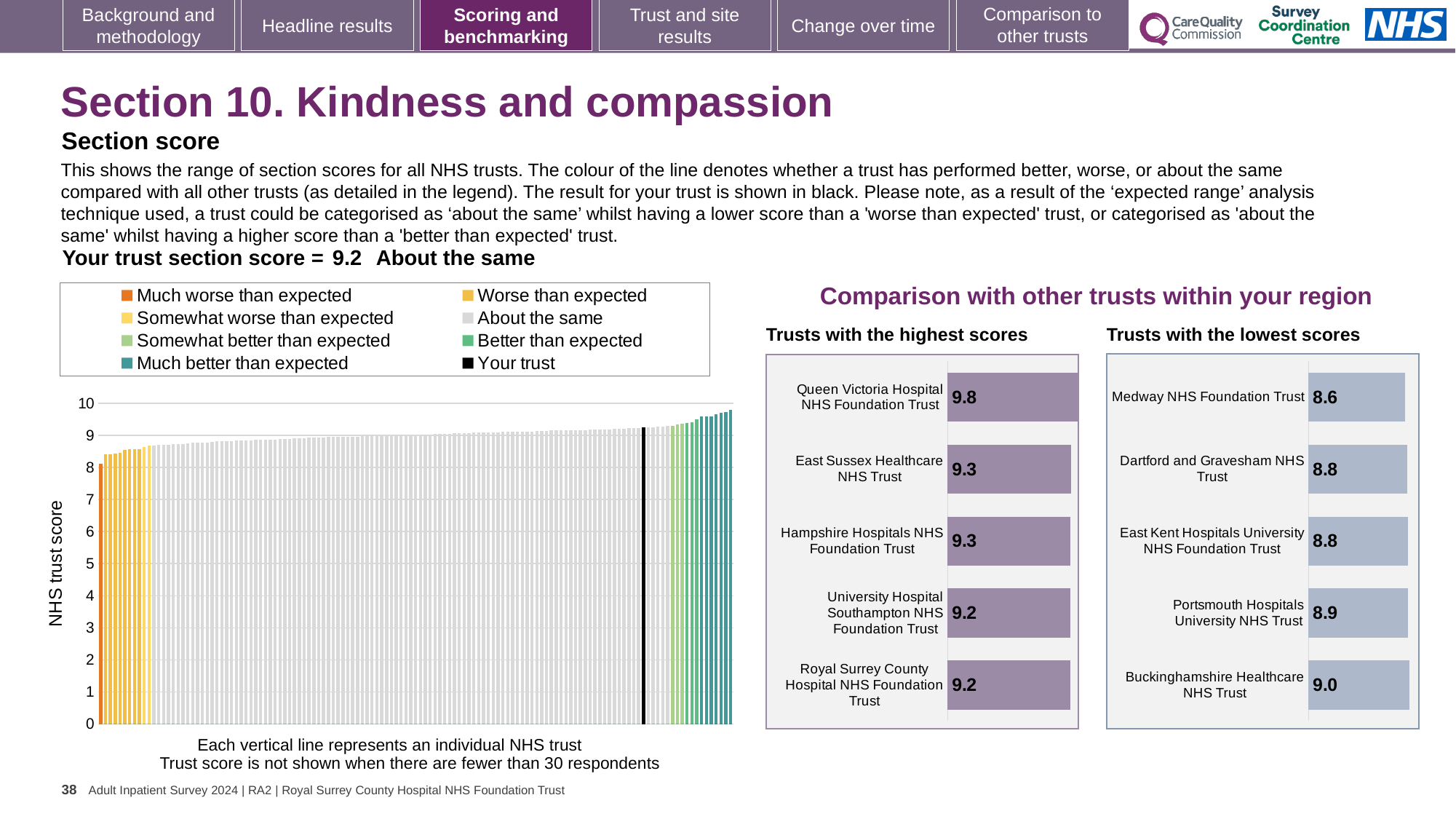
In the 'Trusts with the lowest scores' chart, what is the score for Medway NHS Foundation Trust? 8.6 In the NHS trust score chart on the left, do the values rise or fall from left to right along the x axis? Rise In the 'Trusts with the lowest scores' chart, what is the score for Buckinghamshire Healthcare NHS Trust? 9.0 How many trusts are listed in the 'Trusts with the lowest scores' chart? 5 In the 'Trusts with the highest scores' chart, which trust has the highest score? Queen Victoria Hospital NHS Foundation Trust In the 'Trusts with the highest scores' chart, what is the score for Queen Victoria Hospital NHS Foundation Trust? 9.8 In the 'Trusts with the highest scores' chart, what is the difference between the scores of Queen Victoria Hospital NHS Foundation Trust and Royal Surrey County Hospital NHS Foundation Trust? 0.6 How many entries does the legend of the NHS trust score chart on the left list? 8 What kind of chart is the NHS trust score chart on the left of the slide? Bar chart In the 'Trusts with the lowest scores' chart, which trust has the lowest score? Medway NHS Foundation Trust In the 'Trusts with the lowest scores' chart, which has the higher score: Portsmouth Hospitals University NHS Trust or Medway NHS Foundation Trust? Portsmouth Hospitals University NHS Trust In the NHS trust score chart on the left, is the value of the lowest-scoring trust greater or less than 7? greater